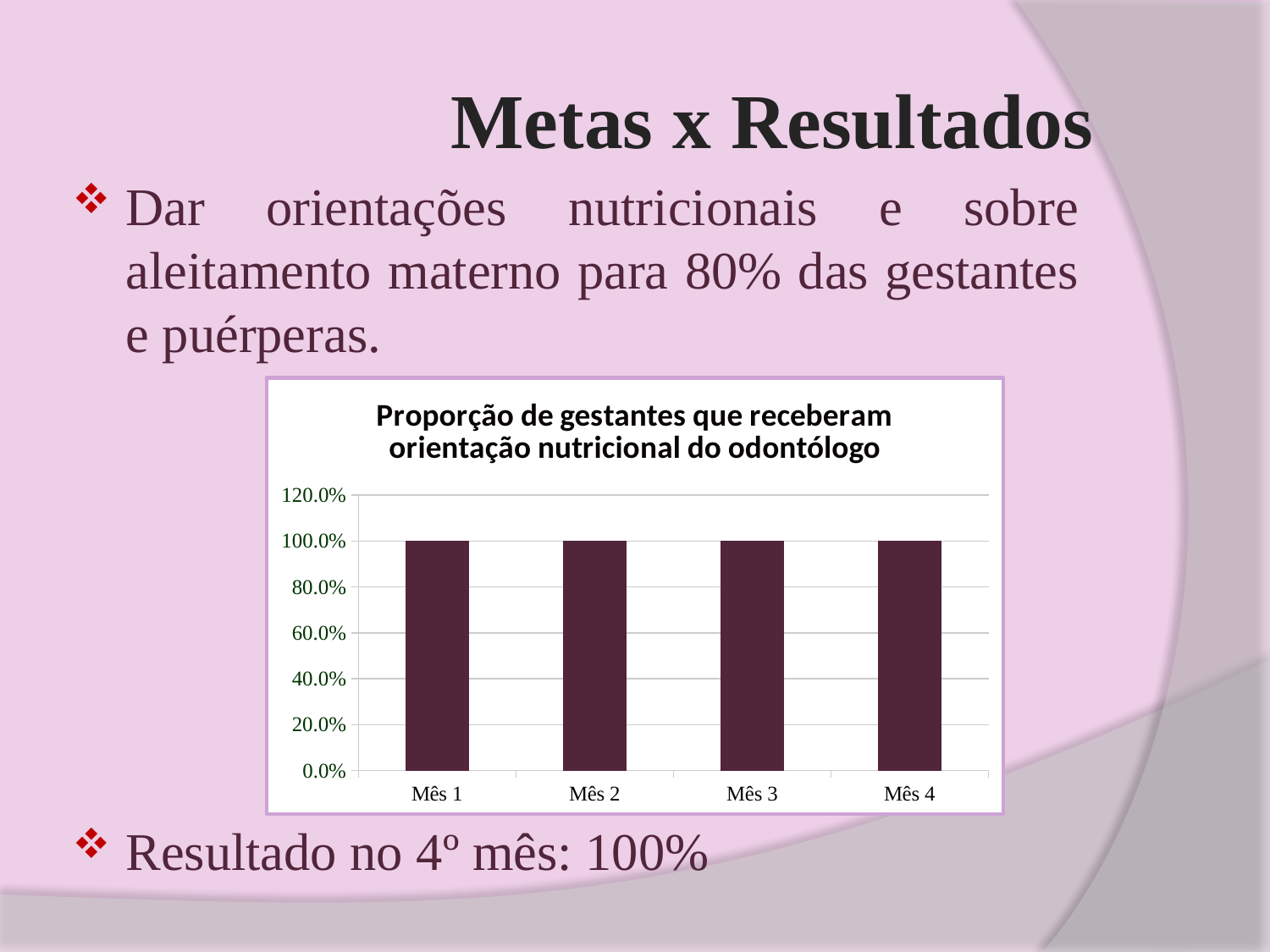
Is the value for Mês 1 greater or less than 120.0%? less Do the values rise, fall, or stay the same from Mês 1 to Mês 4? stay the same What is the difference between the values for Mês 4 and Mês 1? 0.0% What is the value for Mês 2 in the chart? 100.0% What is the value for Mês 4 in the chart? 100.0% What is the title of the chart? Proporção de gestantes que receberam orientação nutricional do odontólogo What kind of chart is shown on the slide? bar chart What is the highest value shown on the y axis of the chart? 120.0% What is the value for Mês 1 in the chart? 100.0% How many categories are plotted on the x axis of the chart? 4 Is the value for Mês 3 greater or less than 80.0%? greater